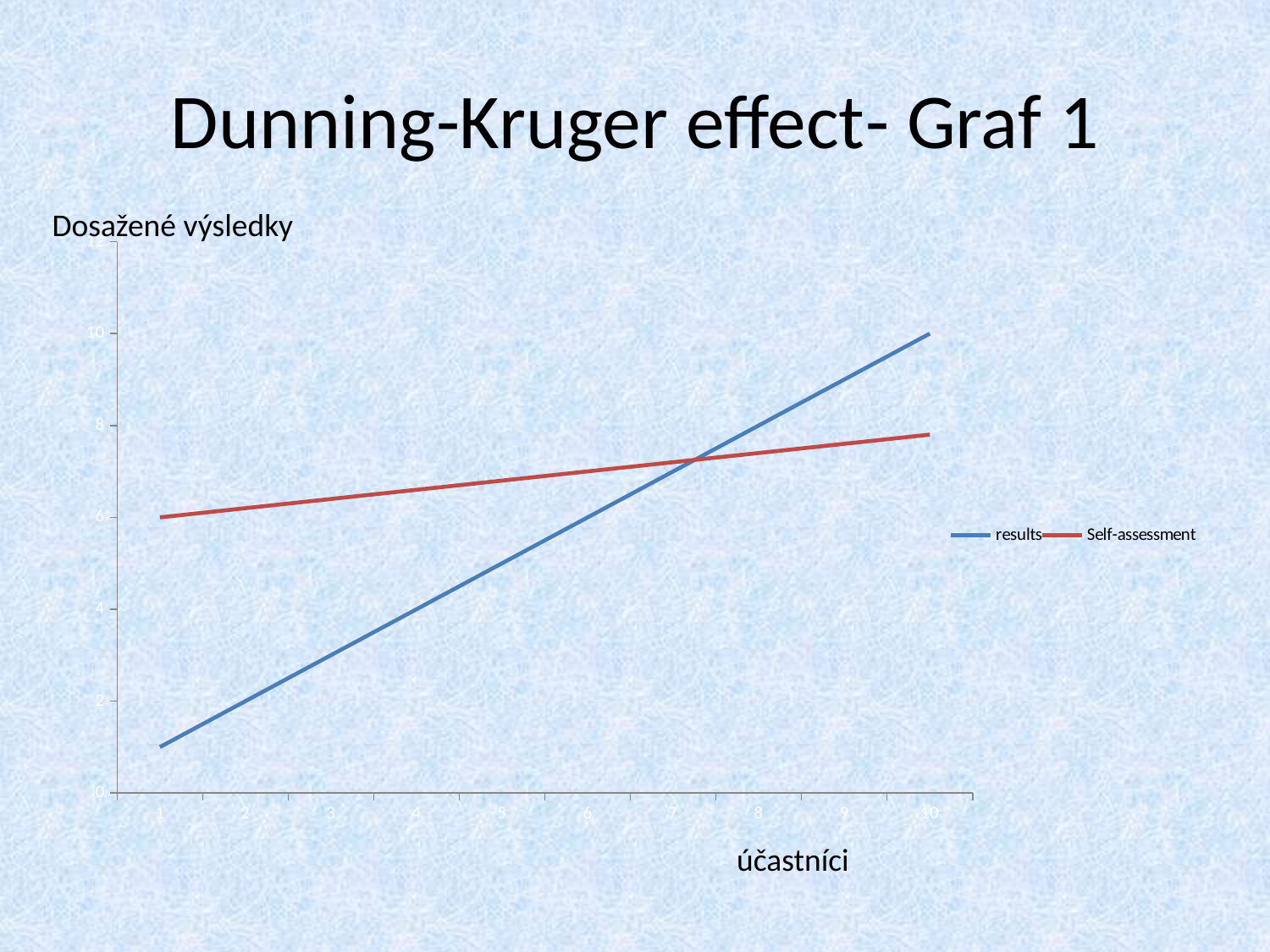
Does the Self-assessment series rise or fall along the x axis? rise For participant 1, which series has the larger value, results or Self-assessment? Self-assessment How many participants (účastníci) are marked along the x axis? 10 Is the results value for participant 1 greater or less than 2? less Does the results series rise or fall as the participant number increases from 1 to 10? rise What kind of chart is shown on the slide? line chart Is the results value for participant 10 greater or less than 8? greater For participant 10, which series has the larger value, results or Self-assessment? results What is the title of the slide containing the chart? Dunning-Kruger effect- Graf 1 How many series does the legend list? 2 Is the Self-assessment value for participant 10 greater or less than 8? less What are the two series named in the legend? results and Self-assessment